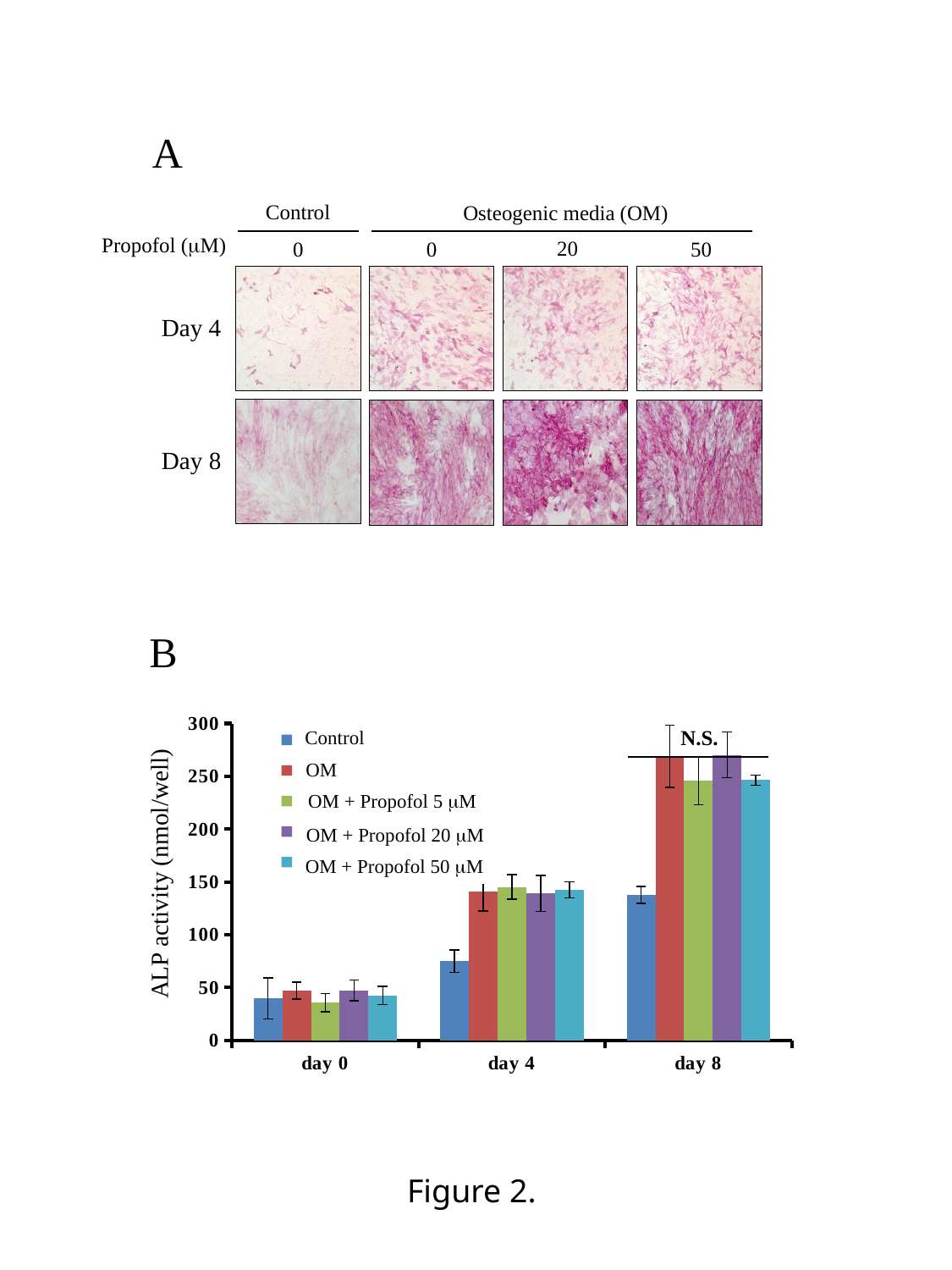
In chart B, is the value for Control at day 4 greater or less than 100? less In chart B, is the value for OM at day 4 greater or less than 100? greater In chart B, is the value for Control at day 8 greater or less than 150? less In chart B, what is the label of the y axis? ALP activity (nmol/well) In chart B, does the Control series rise or fall from day 0 to day 8? rise In chart B, how many categories are shown on the x axis? 3 In chart B, what kind of chart is shown? bar chart In chart B, what annotation is written above the day 8 bars? N.S. In chart B, which is larger at day 4: Control or OM? OM In chart B, how many series does the legend list? 5